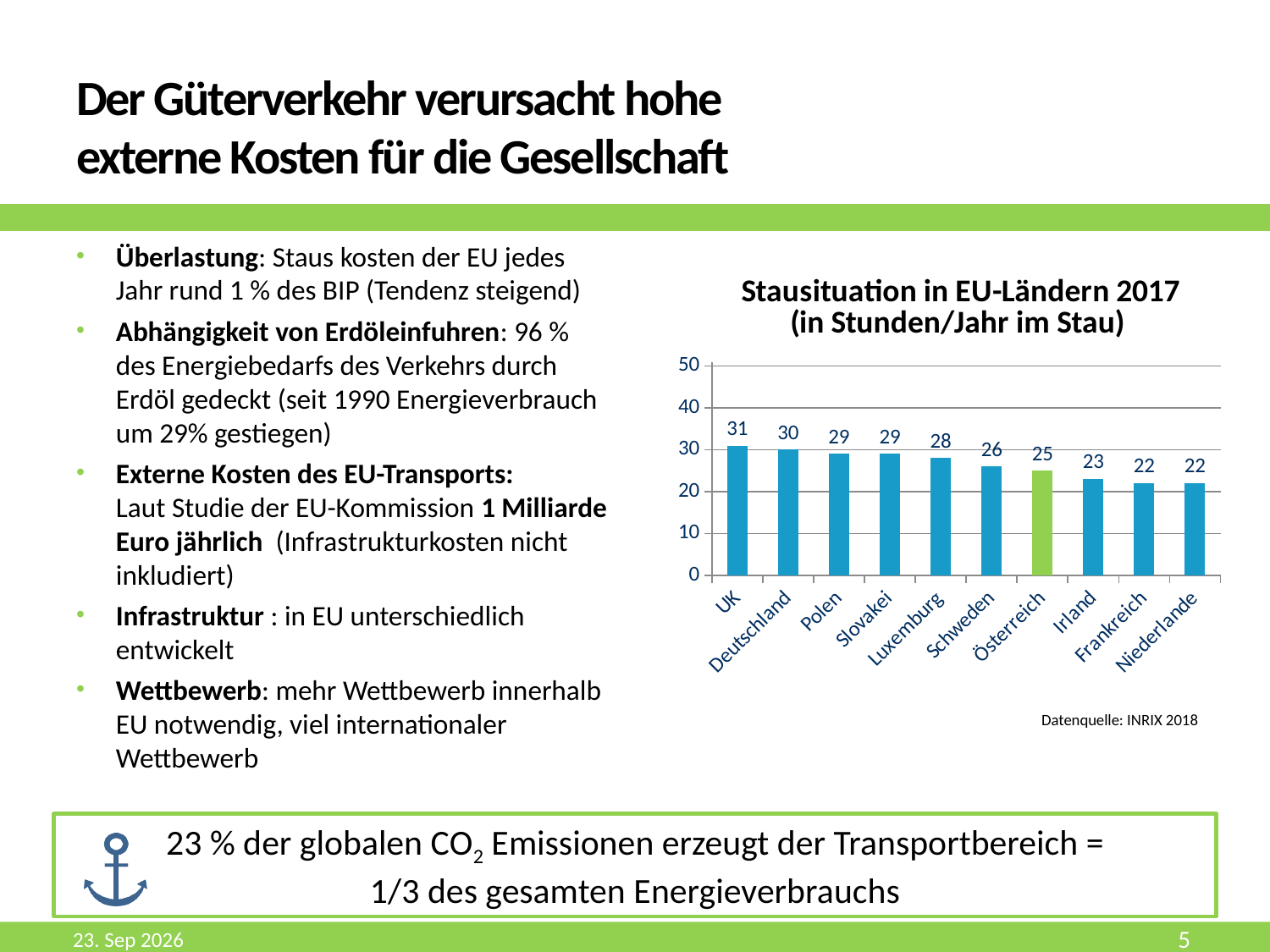
Do the values rise or fall from left to right along the x axis? fall What is the title of the chart? Stausituation in EU-Ländern 2017 (in Stunden/Jahr im Stau) What is the value for UK in the chart? 31 What is the difference between the values for Schweden and Österreich? 1 Which country has the highest value in the chart? UK What kind of chart is shown on the slide? bar chart What is the value for Luxemburg in the chart? 28 What is the value for Österreich in the chart? 25 Which is larger, the value for Deutschland or the value for Irland? Deutschland Is the value for Polen greater or less than 20? greater How many countries are shown in the chart? 10 What is the difference between the values for UK and Niederlande? 9